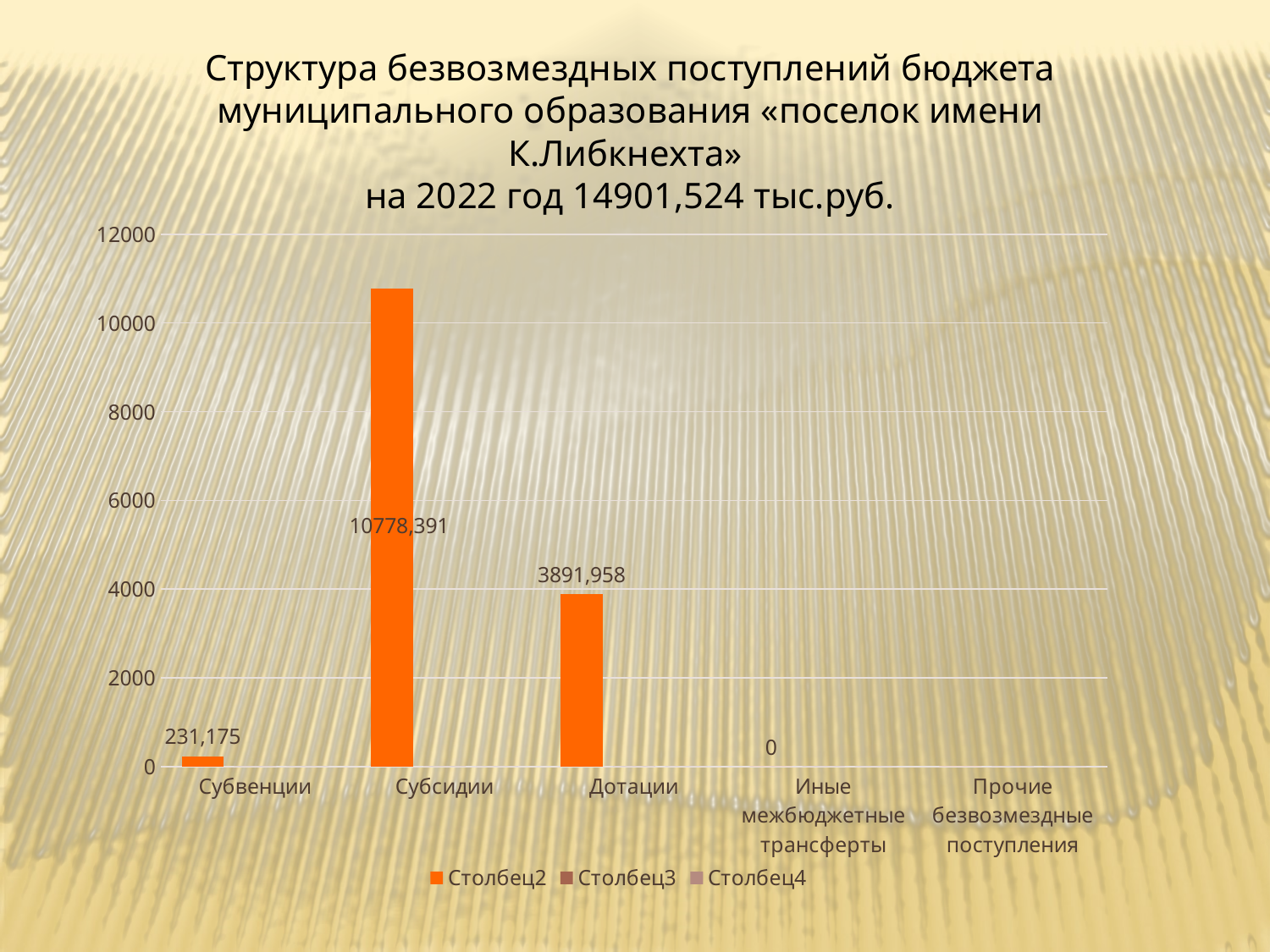
What kind of chart is shown on the slide? bar chart Which category has the highest value? Субсидии Is the value for Субсидии greater or less than 10000? greater What is the difference between the values for Дотации and Субвенции? 3660,783 What is the value for Дотации? 3891,958 Which is larger, the value for Дотации or the value for Субвенции? Дотации What is the value for Иные межбюджетные трансферты? 0 What is the value for Субсидии? 10778,391 What is the value for Субвенции? 231,175 How many categories are shown on the x axis? 5 What is the difference between the values for Субсидии and Дотации? 6886,433 How many series does the legend list? 3